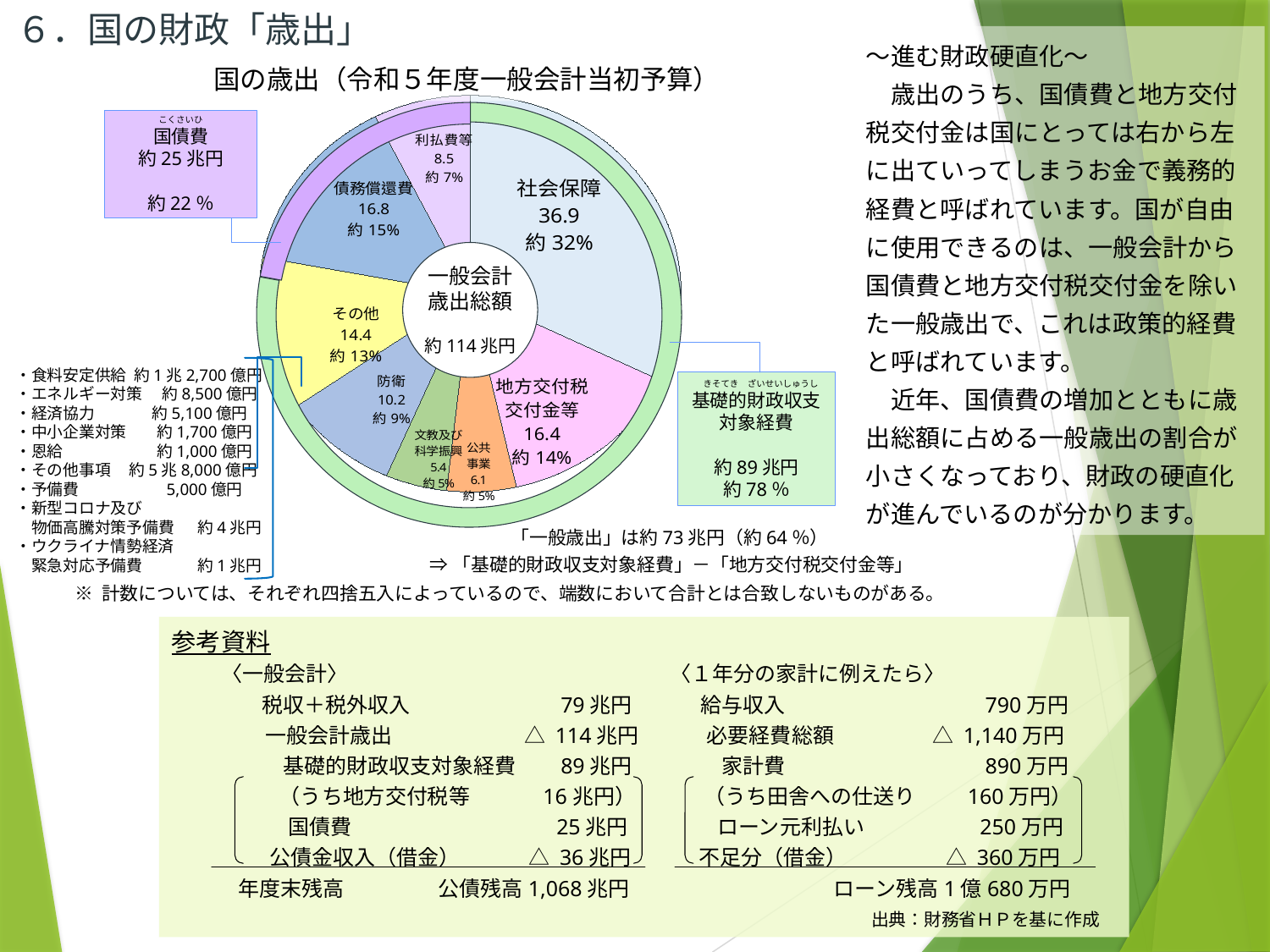
What percentage share is shown for 社会保障? 約 32% Which is larger, 債務償還費 or 利払費等? 債務償還費 What is the value shown for 地方交付税交付金等? 16.4 What is the chart's title? 国の歳出（令和５年度一般会計当初予算） Which category has the smallest slice in the pie chart? 文教及び科学振興 Which category has the largest slice in the pie chart? 社会保障 What total is shown in the centre of the pie chart (一般会計歳出総額)? 約 114 兆円 What is the value shown for 社会保障 in the pie chart? 36.9 How many categories (slices) does the pie chart have? 8 What is the difference between the values for 社会保障 (36.9) and 地方交付税交付金等 (16.4)? 20.5 What kind of chart is shown on the slide? pie chart What percentage share is shown for 防衛? 約 9%